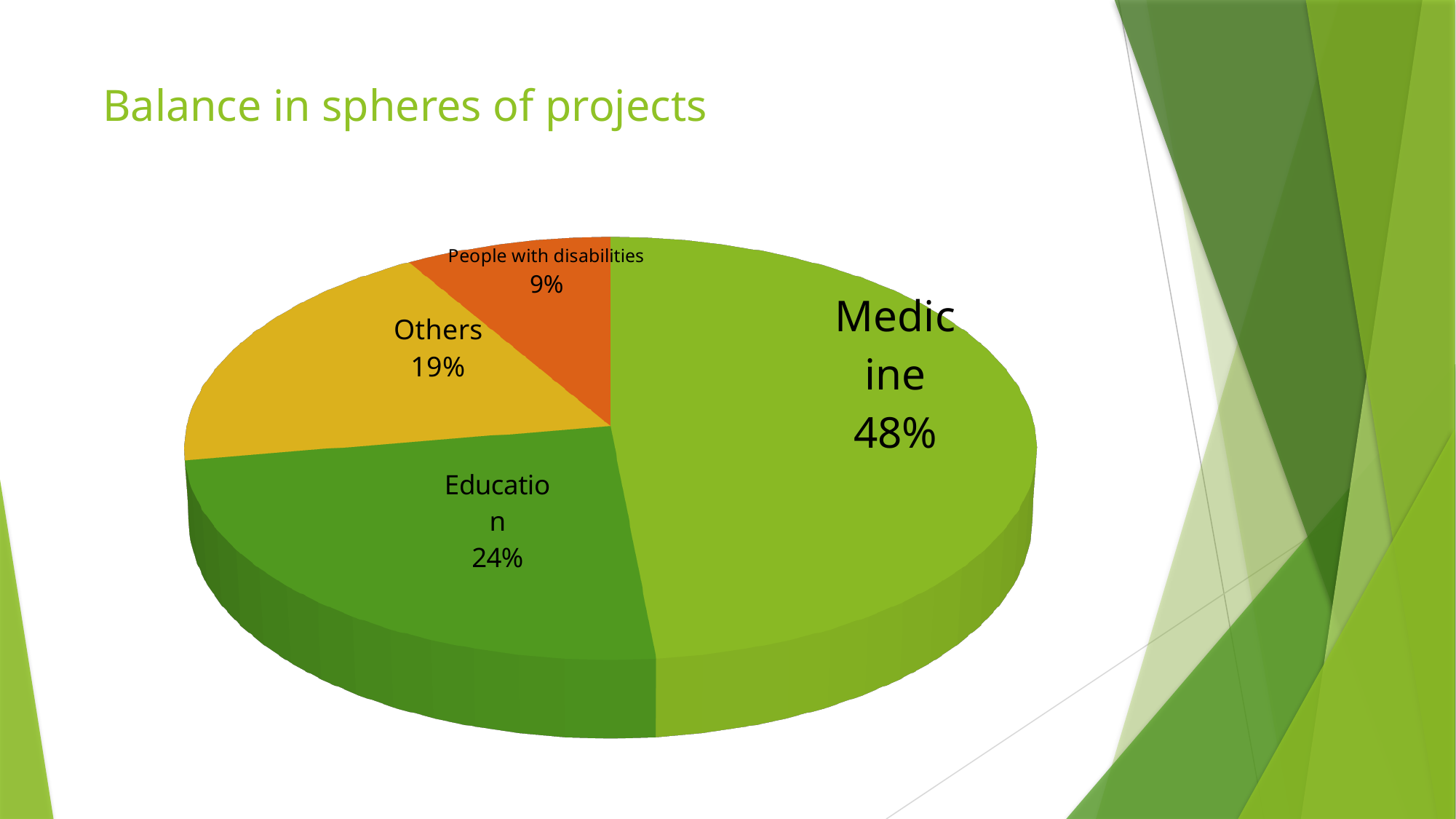
What is the value shown for People with disabilities? 9% What kind of chart is shown on the slide? Pie chart Which is larger, the share for Education or the share for Others? Education What share of the pie does Medicine account for? 48% Which category has the smallest slice of the pie? People with disabilities What is the value shown for Education? 24% How many categories are shown in the pie chart? 4 What is the difference in percentage points between Others and People with disabilities? 10 What is the title of the slide containing the chart? Balance in spheres of projects What is the difference in percentage points between Medicine and Education? 24 Which category has the largest slice of the pie? Medicine What is the value shown for Others? 19%